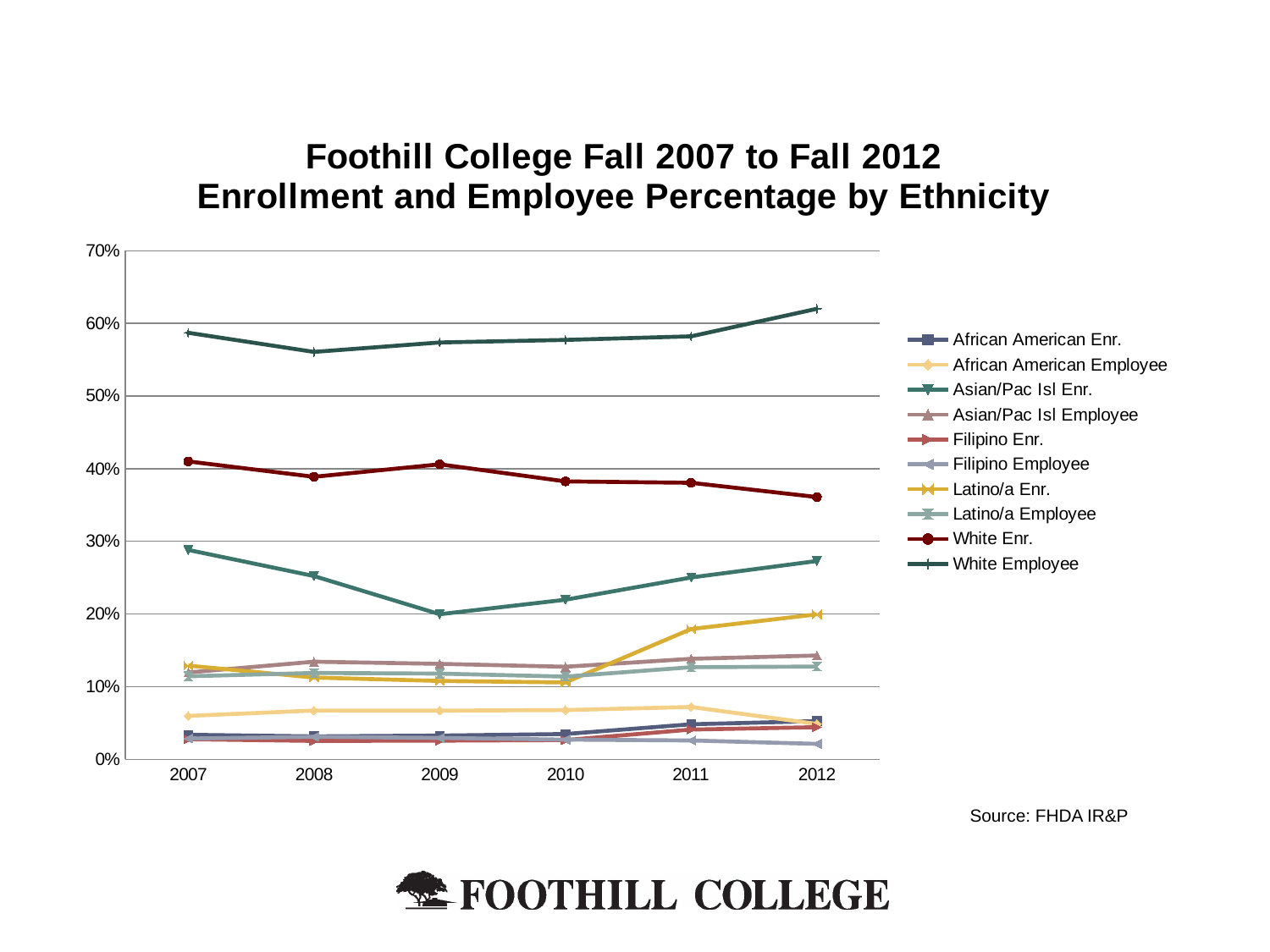
In 2007, which is larger: White Enr. or Asian/Pac Isl Enr.? White Enr. What kind of chart is shown on the slide? line chart Is the value for Asian/Pac Isl Enr. in 2009 greater or less than 30%? less Does the White Enr. line rise or fall overall from 2007 to 2012? fall How many years are shown along the x axis? 6 Is the value for White Employee in 2012 greater or less than 60%? greater How many series does the legend list? 10 Does the Latino/a Enr. line rise or fall from 2010 to 2012? rise Which series has the lowest value in 2012? Filipino Employee Which series has the highest value in 2012? White Employee What source is cited for the chart? FHDA IR&P Is the value for White Enr. in 2012 greater or less than 40%? less